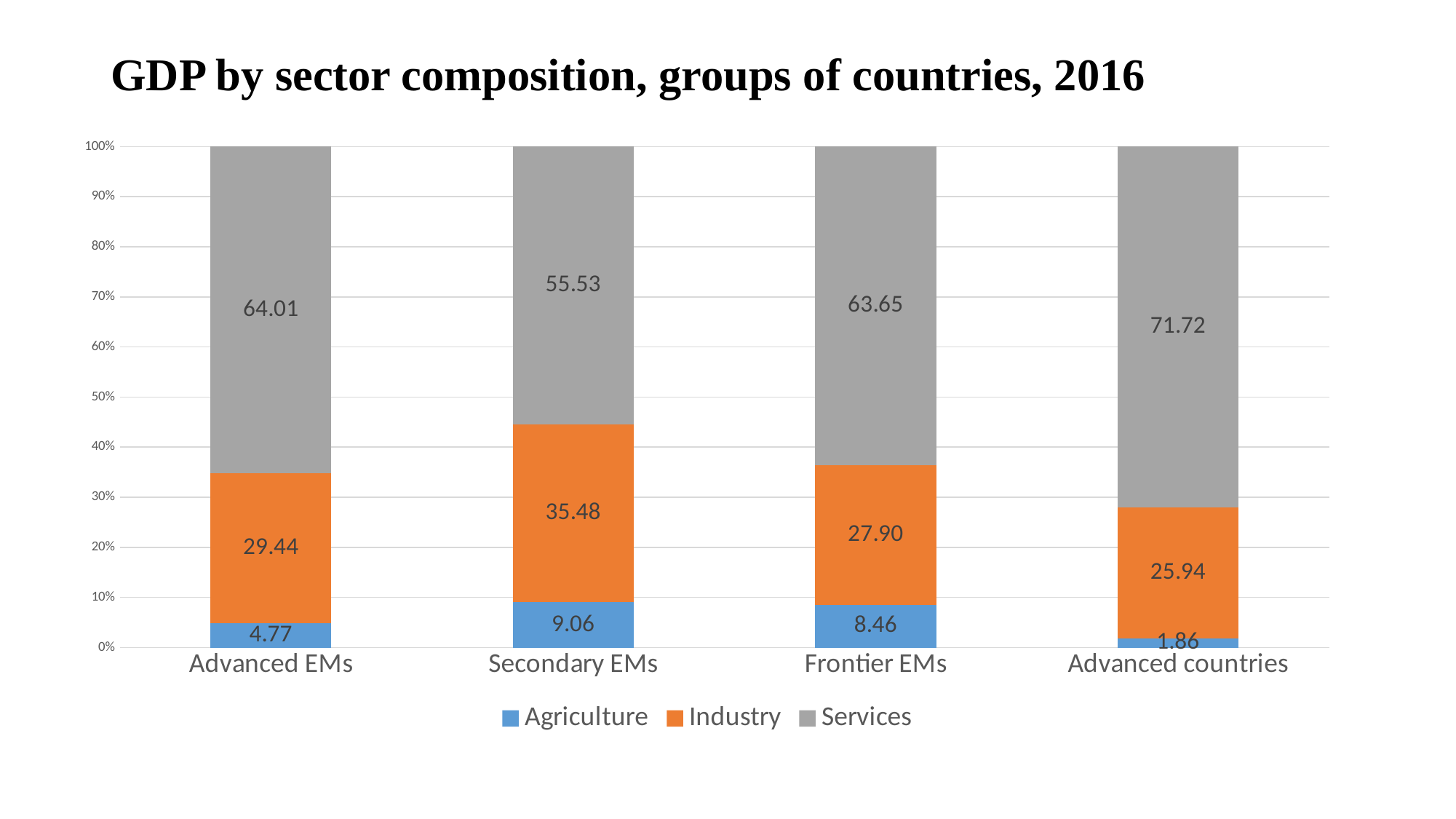
Which is larger, the Industry value for Advanced EMs or for Advanced countries? Advanced EMs What is the Services value for Advanced countries? 71.72 What is the title of the chart? GDP by sector composition, groups of countries, 2016 What kind of chart is shown on the slide? Stacked bar chart How many series does the legend list? 3 How many groups of countries are shown on the x axis? 4 Which colour represents Services in the chart? Grey Which group of countries has the highest Industry value? Secondary EMs What is the difference between the Services values for Advanced countries and Secondary EMs? 16.19 Which group of countries has the lowest Agriculture value? Advanced countries What is the Industry value for Frontier EMs? 27.90 What is the Agriculture value for Secondary EMs? 9.06